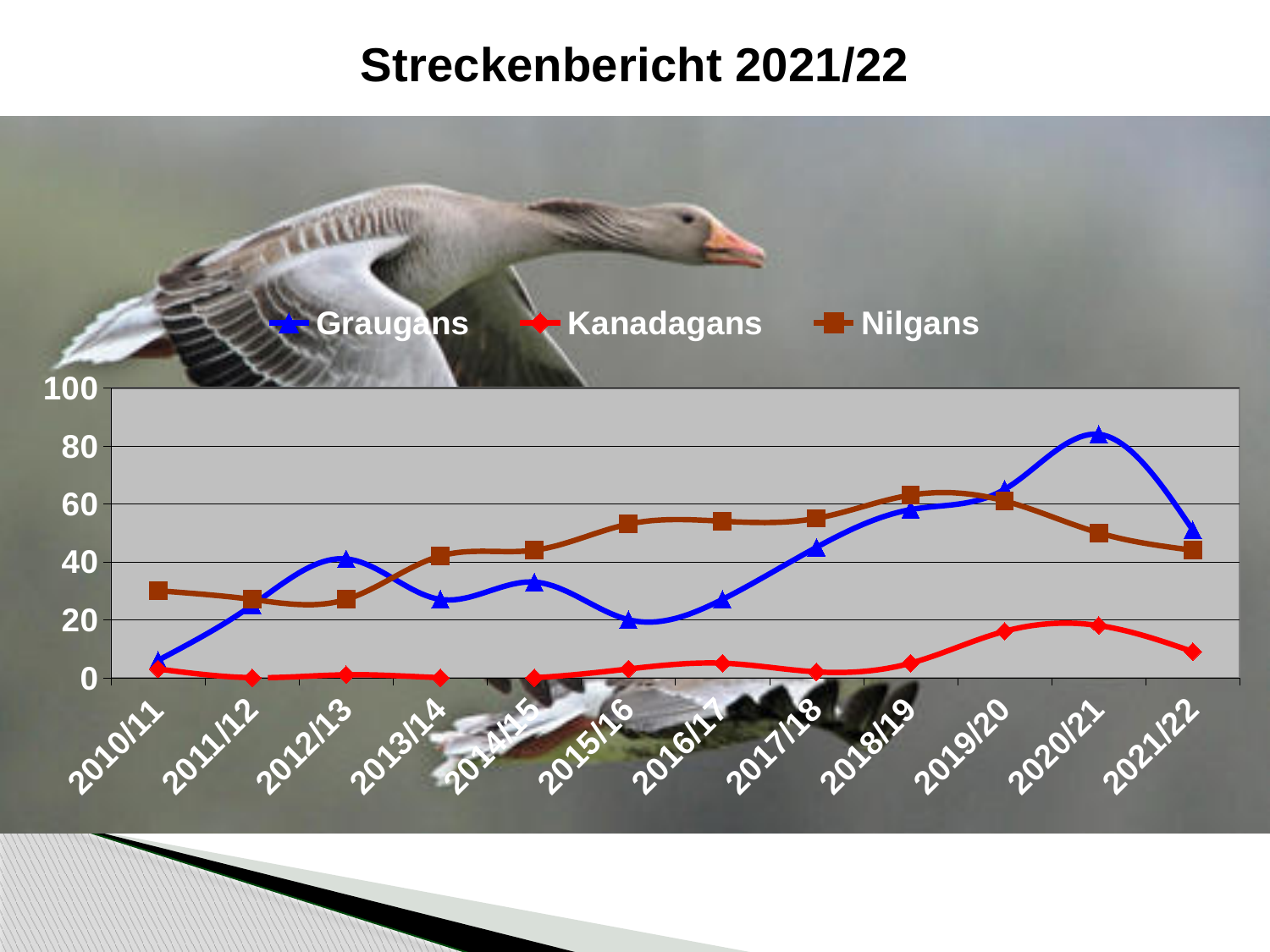
Does the Graugans series rise or fall from 2017/18 to 2020/21? rise In 2012/13, which series has the larger value, Graugans or Nilgans? Graugans In which season does the Graugans series reach its highest value? 2020/21 Is the value for Graugans in 2010/11 greater or less than 20? less How many seasons are plotted along the x axis? 12 What kind of chart is shown on the slide? line chart Is the value for Nilgans in 2010/11 greater or less than 40? less In 2015/16, which series has the larger value, Graugans or Nilgans? Nilgans Is the value for Graugans in 2020/21 greater or less than 80? greater What is the title of the slide containing the chart? Streckenbericht 2021/22 How many series does the legend list? 3